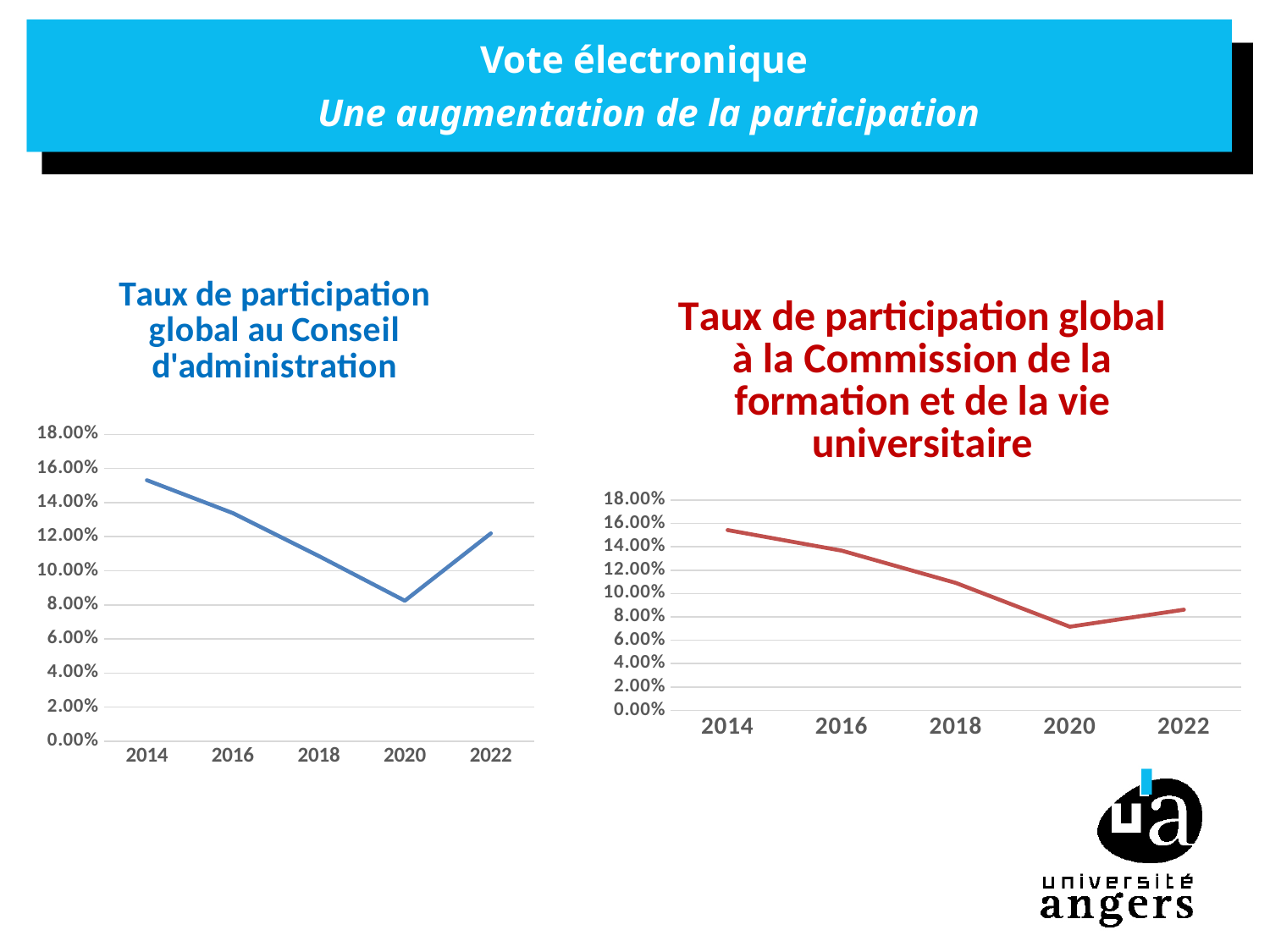
In the 'Taux de participation global à la Commission de la formation et de la vie universitaire' chart, which year has the highest participation rate? 2014 In the 'Taux de participation global à la Commission de la formation et de la vie universitaire' chart, is the value for 2014 greater or less than 14.00%? greater What type of chart is the 'Taux de participation global au Conseil d'administration' chart? line chart In the 'Taux de participation global à la Commission de la formation et de la vie universitaire' chart, is the value for 2022 greater or less than 10.00%? less In the 'Taux de participation global au Conseil d'administration' chart, is the value for 2020 greater or less than 10.00%? less In the 'Taux de participation global à la Commission de la formation et de la vie universitaire' chart, which year has the lowest participation rate? 2020 In the 'Taux de participation global au Conseil d'administration' chart, which year has the lowest participation rate? 2020 In the 'Taux de participation global au Conseil d'administration' chart, how many years are shown on the x axis? 5 In the 'Taux de participation global au Conseil d'administration' chart, does the participation rate rise or fall between 2014 and 2020? fall What type of chart is the 'Taux de participation global à la Commission de la formation et de la vie universitaire' chart? line chart In the 'Taux de participation global au Conseil d'administration' chart, which year has the highest participation rate? 2014